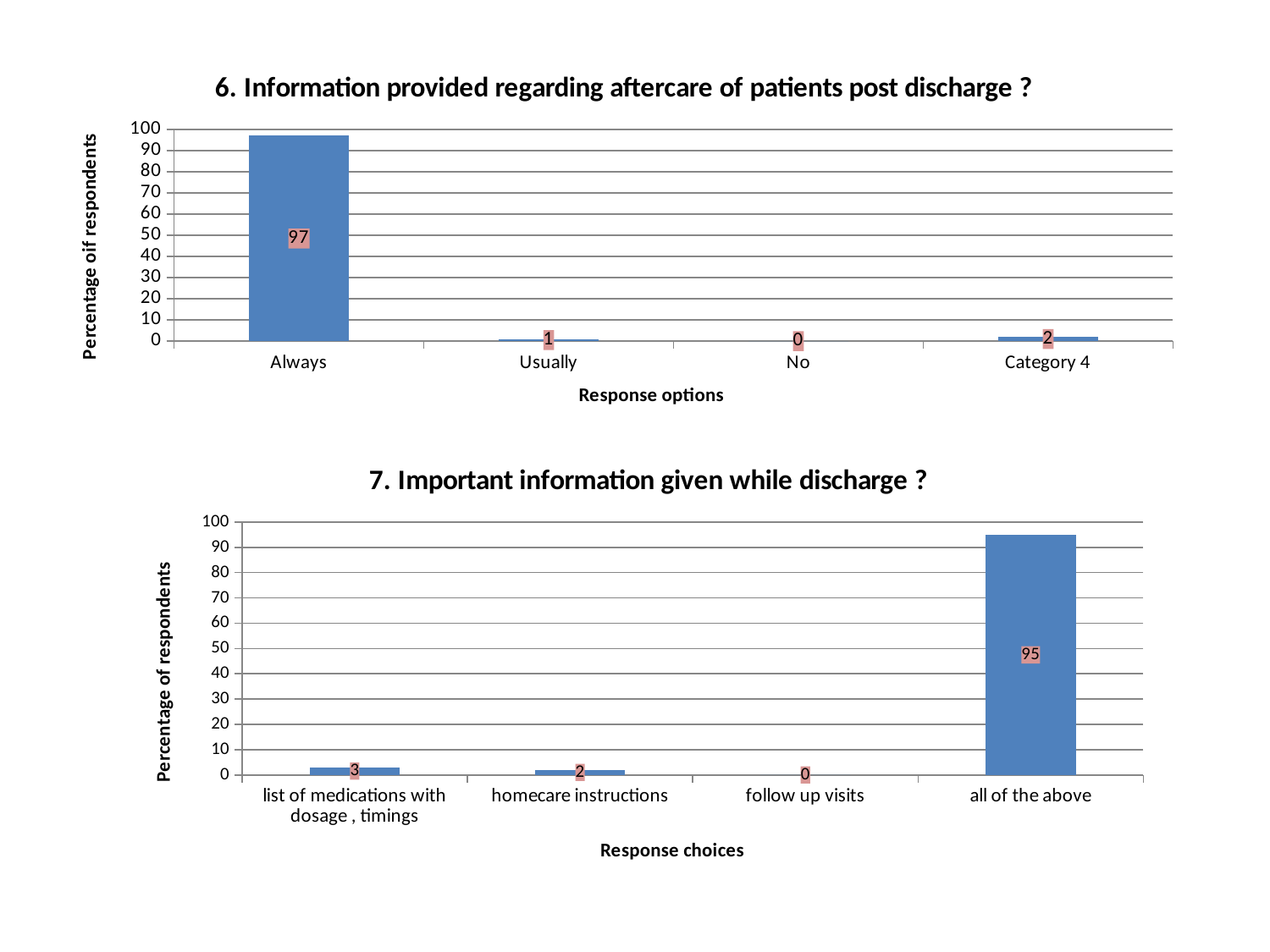
In the bottom chart (question 7), what is the value for homecare instructions? 2 In the bottom chart (question 7), which is larger: the value for list of medications with dosage, timings or the value for homecare instructions? list of medications with dosage, timings In the top chart (question 6), which response option has the lowest value? No In the top chart (question 6), which response option has the highest value? Always In the top chart (question 6), how many response options are shown on the x axis? 4 In the bottom chart (question 7), which response choice has the lowest value? follow up visits In the top chart (question 6), what is the value for Category 4? 2 In the bottom chart (question 7), what is the difference between the values for all of the above and list of medications with dosage, timings? 92 What kind of chart is the bottom chart (question 7)? Bar chart In the top chart (question 6), what is the difference between the values for Always and Usually? 96 In the top chart (question 6), what is the value for Always? 97 In the bottom chart (question 7), what is the value for all of the above? 95